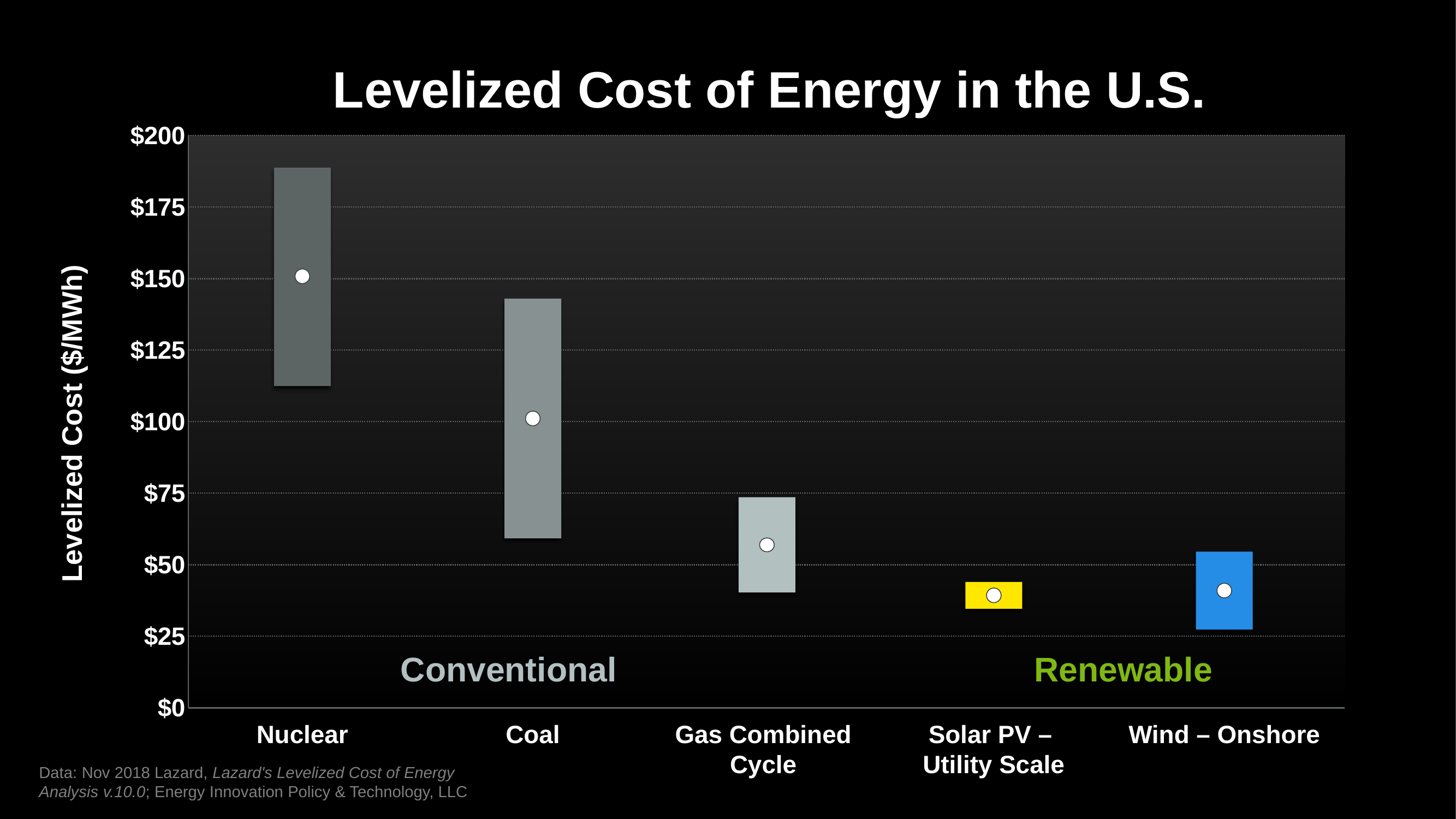
Do the midpoint values rise or fall from Nuclear to Gas Combined Cycle along the x axis? fall Which category has the highest midpoint value? Nuclear Is the midpoint value for Solar PV – Utility Scale greater or less than $50? less Is the bottom of the Nuclear range greater or less than $100? greater Which category's range reaches the lowest top value? Solar PV – Utility Scale What is the title of the chart? Levelized Cost of Energy in the U.S. How many energy categories are shown on the x axis? 5 Is the midpoint value for Gas Combined Cycle greater or less than $75? less Which has the larger midpoint value, Coal or Gas Combined Cycle? Coal What is the label on the vertical axis? Levelized Cost ($/MWh) What kind of chart is this? Bar chart